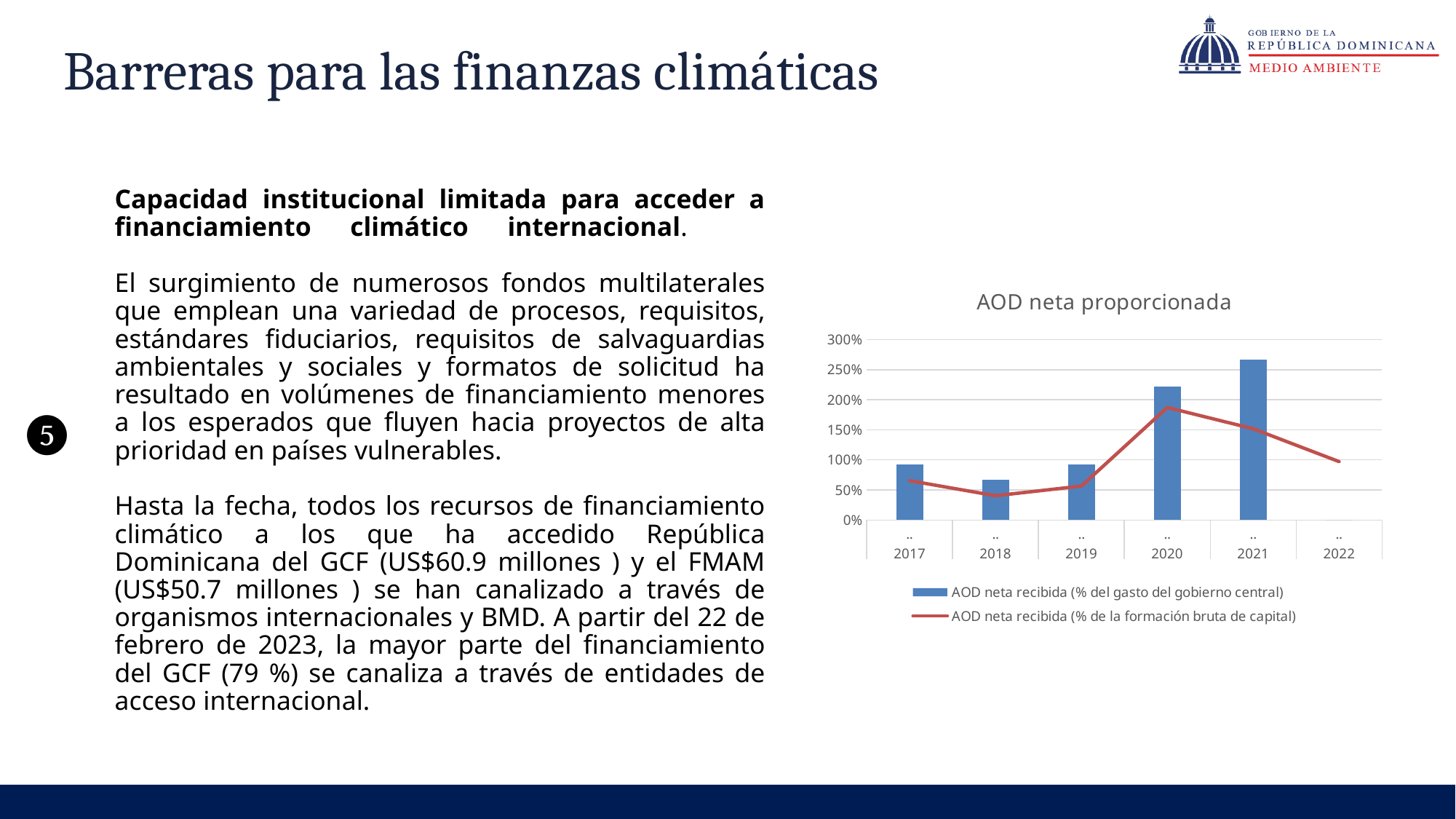
In which year does the line for AOD neta recibida (% de la formación bruta de capital) reach its lowest point? 2018 Which year has the tallest bar for AOD neta recibida (% del gasto del gobierno central)? 2021 In which year does the line for AOD neta recibida (% de la formación bruta de capital) reach its highest point? 2020 How many years are shown on the x axis of the chart? 6 Which year has the larger bar for AOD neta recibida (% del gasto del gobierno central), 2020 or 2021? 2021 What kind of chart is shown on the slide? A combined bar and line chart Is the line value for 2018 (% de la formación bruta de capital) greater or less than 50%? less Which year has the shortest bar for AOD neta recibida (% del gasto del gobierno central)? 2018 Does the line for AOD neta recibida (% de la formación bruta de capital) rise or fall from 2020 to 2022? fall How many series does the chart legend list? 2 What is the title of the chart on the slide? AOD neta proporcionada Is the bar value for 2021 (% del gasto del gobierno central) greater or less than 250%? greater